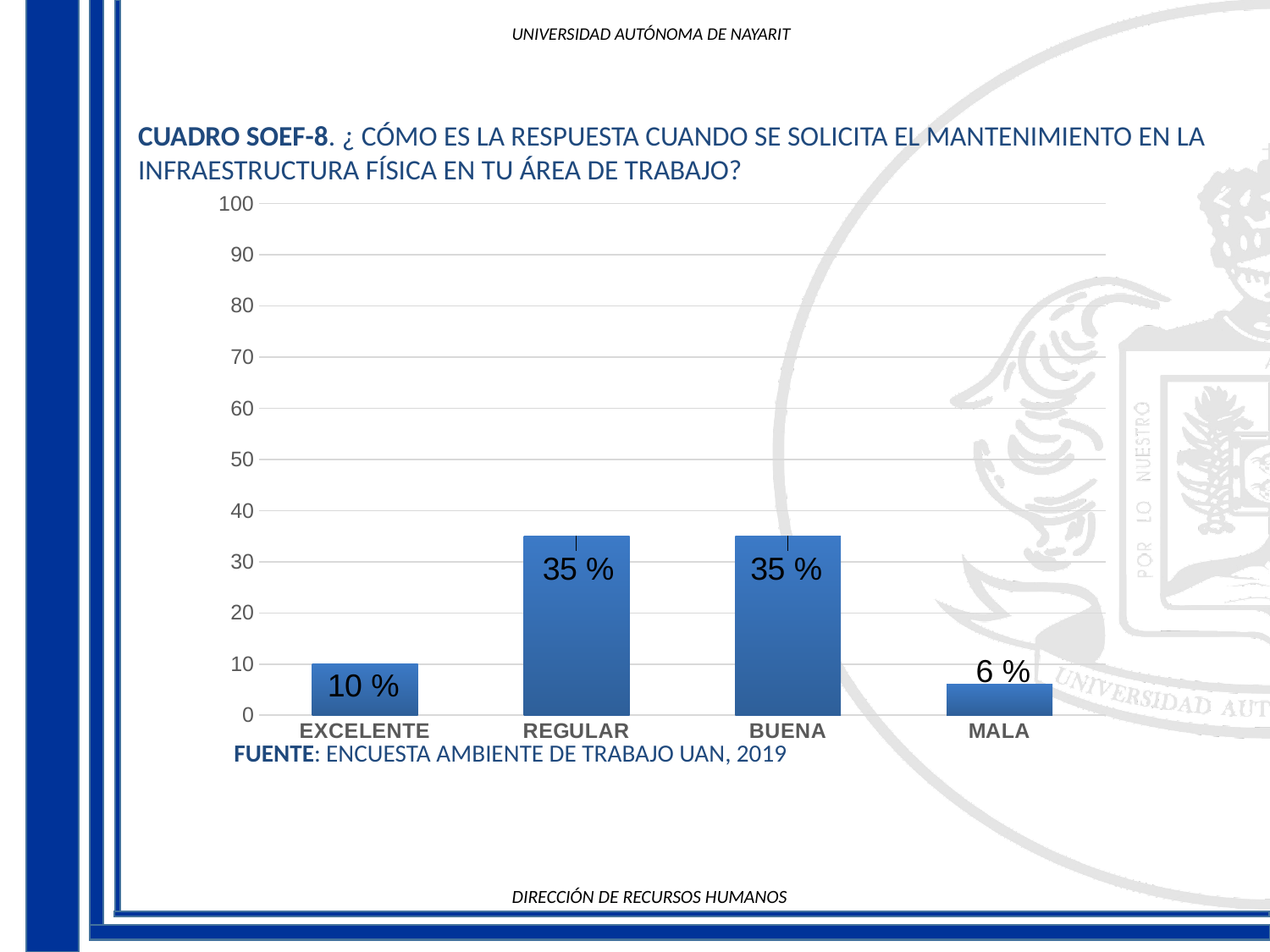
Is the value for BUENA greater or less than 30? greater What is the difference between the values for REGULAR and EXCELENTE? 25 % What kind of chart is shown on the slide? bar chart What is the value for EXCELENTE? 10 % What is the difference between the values for EXCELENTE and MALA? 4 % What is the source cited below the chart? ENCUESTA AMBIENTE DE TRABAJO UAN, 2019 Is the value for MALA greater or less than 10? less Which category has the lowest value? MALA What is the value for REGULAR? 35 % Which is larger, the value for EXCELENTE or the value for MALA? EXCELENTE What is the value for MALA? 6 % How many categories are shown on the x axis? 4